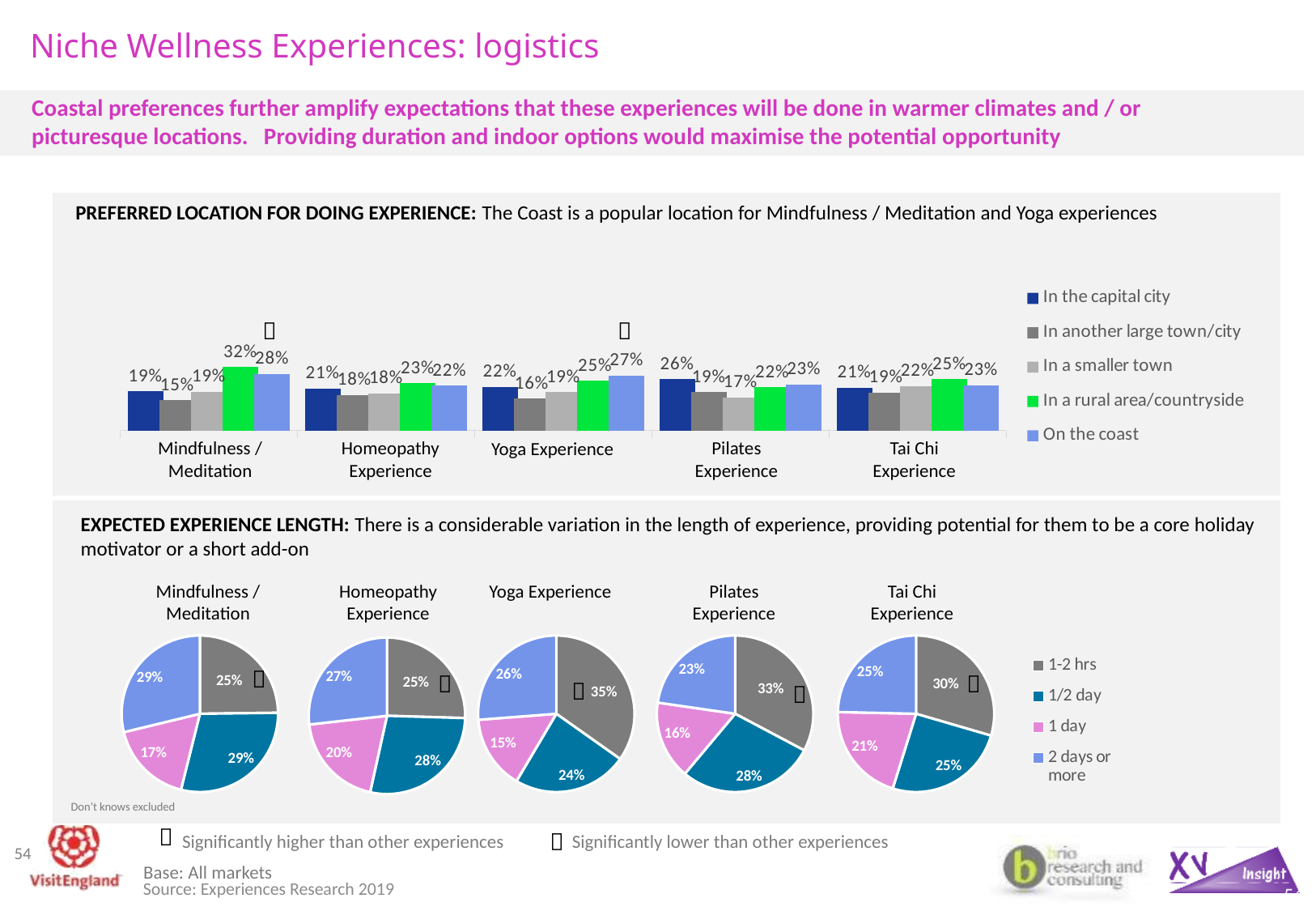
In the Preferred Location bar chart, what is the value for 'In the capital city' for Pilates Experience? 26% In the Preferred Location bar chart, which location has the highest value for Mindfulness / Meditation? In a rural area/countryside In the Preferred Location bar chart, what is the value for 'In a rural area/countryside' for Mindfulness / Meditation? 32% How many pie charts are shown in the Expected Experience Length section? 5 In the Expected Experience Length pie chart for Yoga Experience, what share is '1-2 hrs'? 35% What type of chart is used for Preferred Location for Doing Experience? Bar chart In the Preferred Location bar chart, which location has the lowest value for Yoga Experience? In another large town/city In the Preferred Location bar chart, what is the difference between 'In a rural area/countryside' and 'In another large town/city' for Mindfulness / Meditation? 17 percentage points In the Preferred Location bar chart, what is the value for 'On the coast' for Yoga Experience? 27% In the Preferred Location bar chart, how many series does the legend list? 5 In the Expected Experience Length pie chart for Pilates Experience, which length has the smallest share? 1 day In the Expected Experience Length pie chart for Tai Chi Experience, what share is '1 day'? 21%